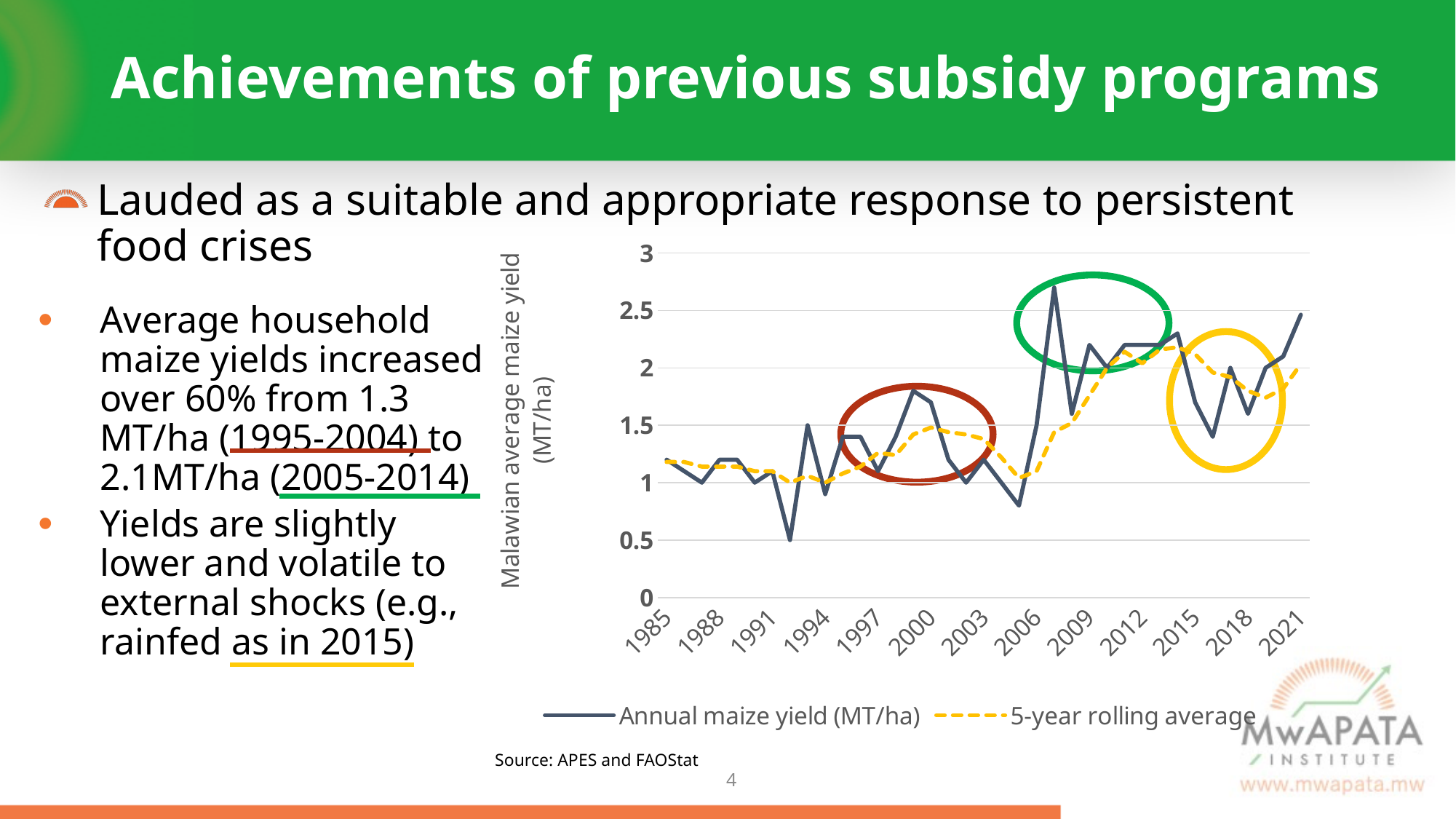
Is the lowest value of the annual maize yield series greater or less than 1? less Is the annual maize yield value for 2021 greater or less than 2? greater Is the annual maize yield value for 1985 greater or less than 1? greater What are the two series named in the chart legend? Annual maize yield (MT/ha) and 5-year rolling average What type of chart is shown on the slide? Line chart In which year does the annual maize yield series reach its highest value? 2007 Overall, does the annual maize yield rise or fall from 1985 to 2021? rise What is the label of the chart's vertical axis? Malawian average maize yield (MT/ha) How many series does the chart legend list? 2